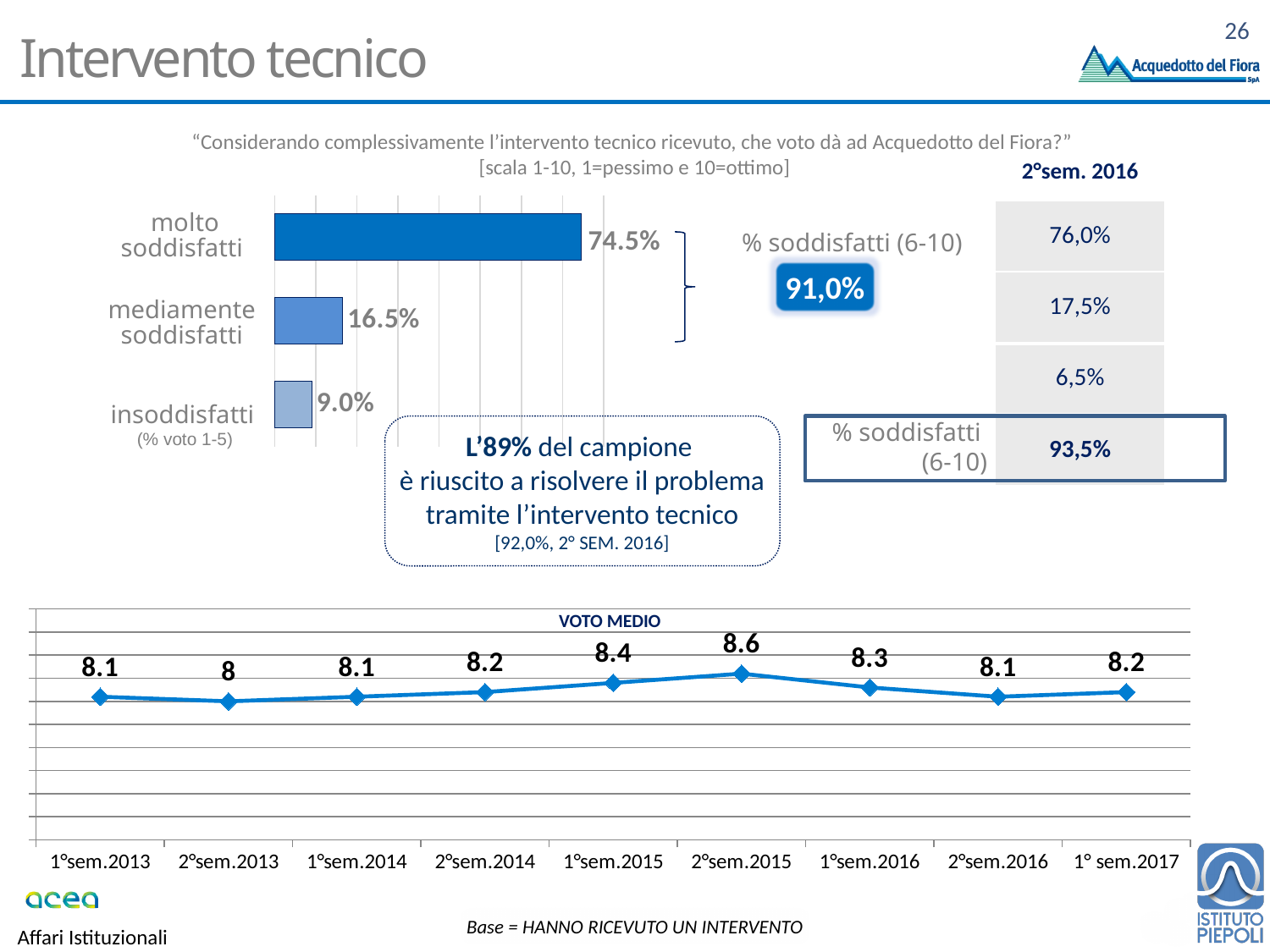
In the top bar chart, how many categories are shown? 3 In the top bar chart, what is the value for "molto soddisfatti"? 74.5% In the VOTO MEDIO line chart, what is the value for 2°sem.2015? 8.6 What kind of chart is the top chart on the slide? Bar chart In the top bar chart, what is the value for "insoddisfatti"? 9.0% In the VOTO MEDIO line chart, which period has the highest value? 2°sem.2015 In the VOTO MEDIO line chart, how many data points are plotted? 9 In the VOTO MEDIO line chart, which period has the lowest value? 2°sem.2013 In the top bar chart, which category has the lowest value? insoddisfatti In the VOTO MEDIO line chart, what is the value for 1° sem.2017? 8.2 In the VOTO MEDIO line chart, is the value for 1°sem.2015 larger or smaller than the value for 1°sem.2016? larger In the top bar chart, what is the difference between "molto soddisfatti" and "mediamente soddisfatti"? 58.0 percentage points